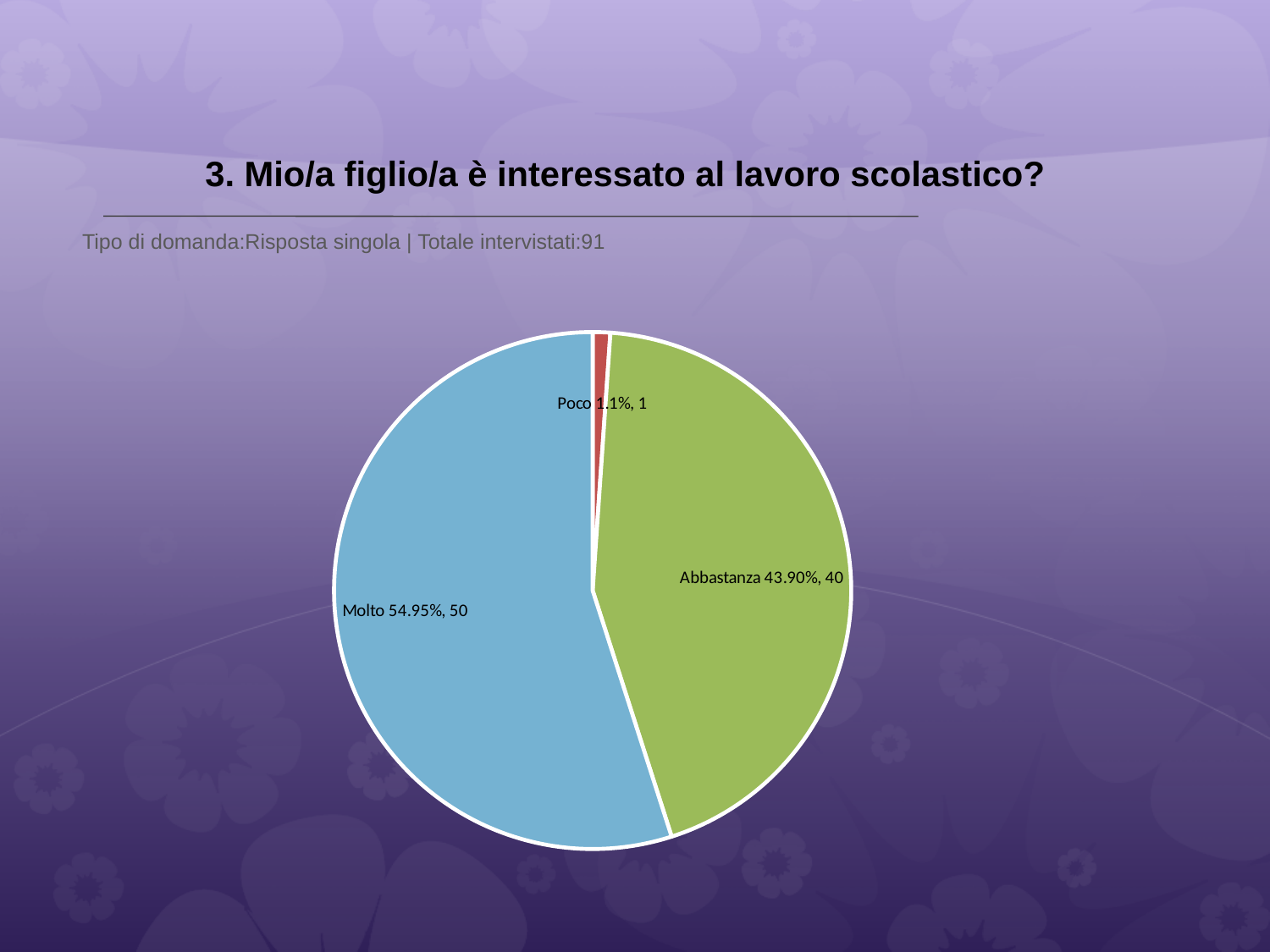
What percentage share does the 'Abbastanza' slice have? 43.90% How many respondents answered 'Molto'? 50 What kind of chart is shown on the slide? pie chart How many respondents answered 'Abbastanza'? 40 Which category has the largest slice? Molto How many respondents answered 'Poco'? 1 What percentage share does the 'Poco' slice have? 1.1% Which category has the smallest slice? Poco What percentage share does the 'Molto' slice have? 54.95% How many slices does the pie chart have? 3 What is the difference in respondent count between 'Molto' and 'Abbastanza'? 10 What is the title of the chart? 3. Mio/a figlio/a è interessato al lavoro scolastico?